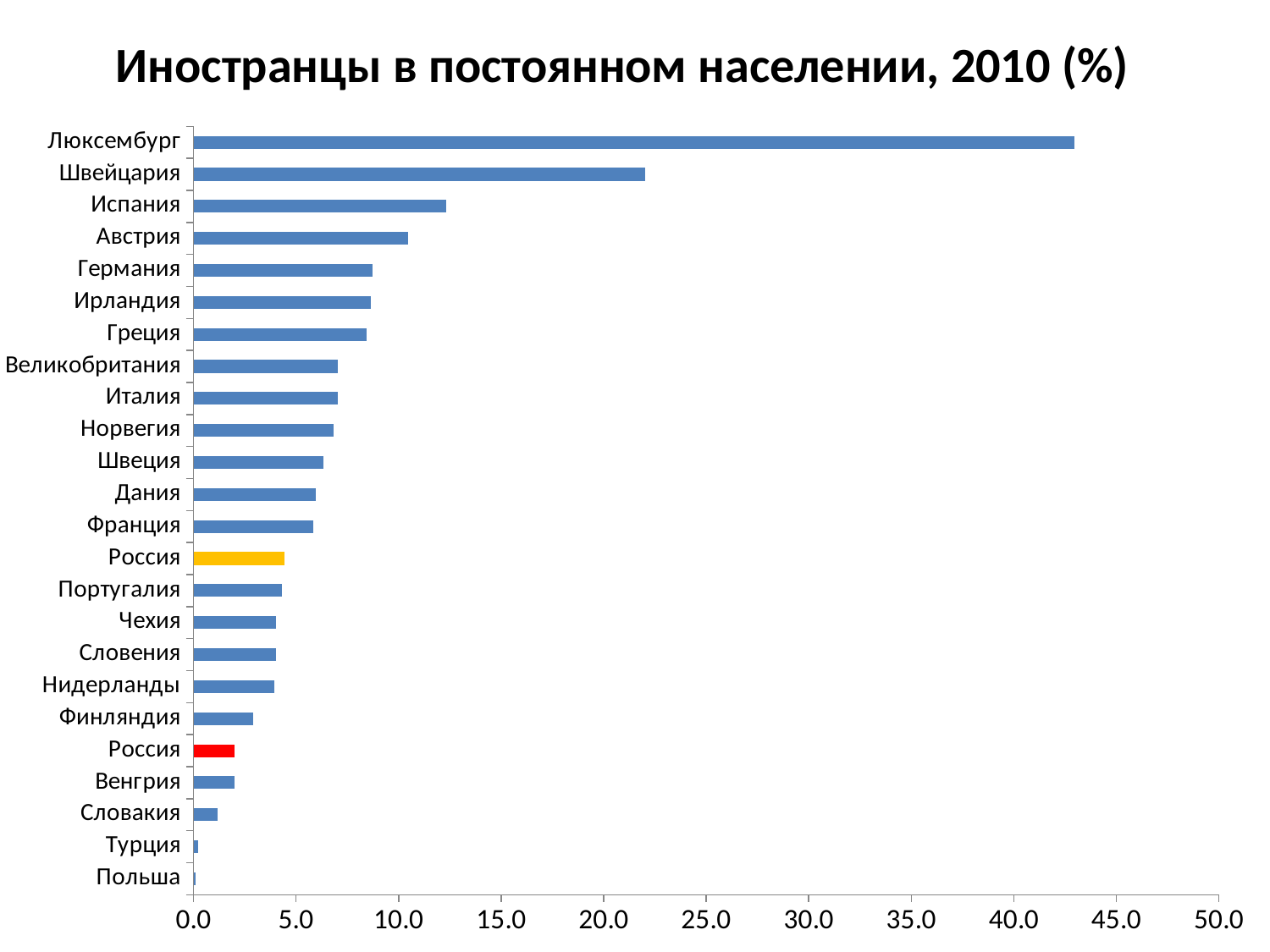
Which has a larger value, Швейцария or Испания? Швейцария Is the value for Германия greater or less than 10.0? less What is the title of the chart? Иностранцы в постоянном населении, 2010 (%) Do the bar values increase or decrease going from the top of the chart to the bottom? decrease How many bars (categories) are shown in the chart? 24 Is the value for Швейцария greater or less than 20.0? greater Is the value for Люксембург greater or less than 40.0? greater Which country has the highest value in the chart? Люксембург Which country has the lowest value in the chart? Польша What kind of chart is shown on the slide? bar chart